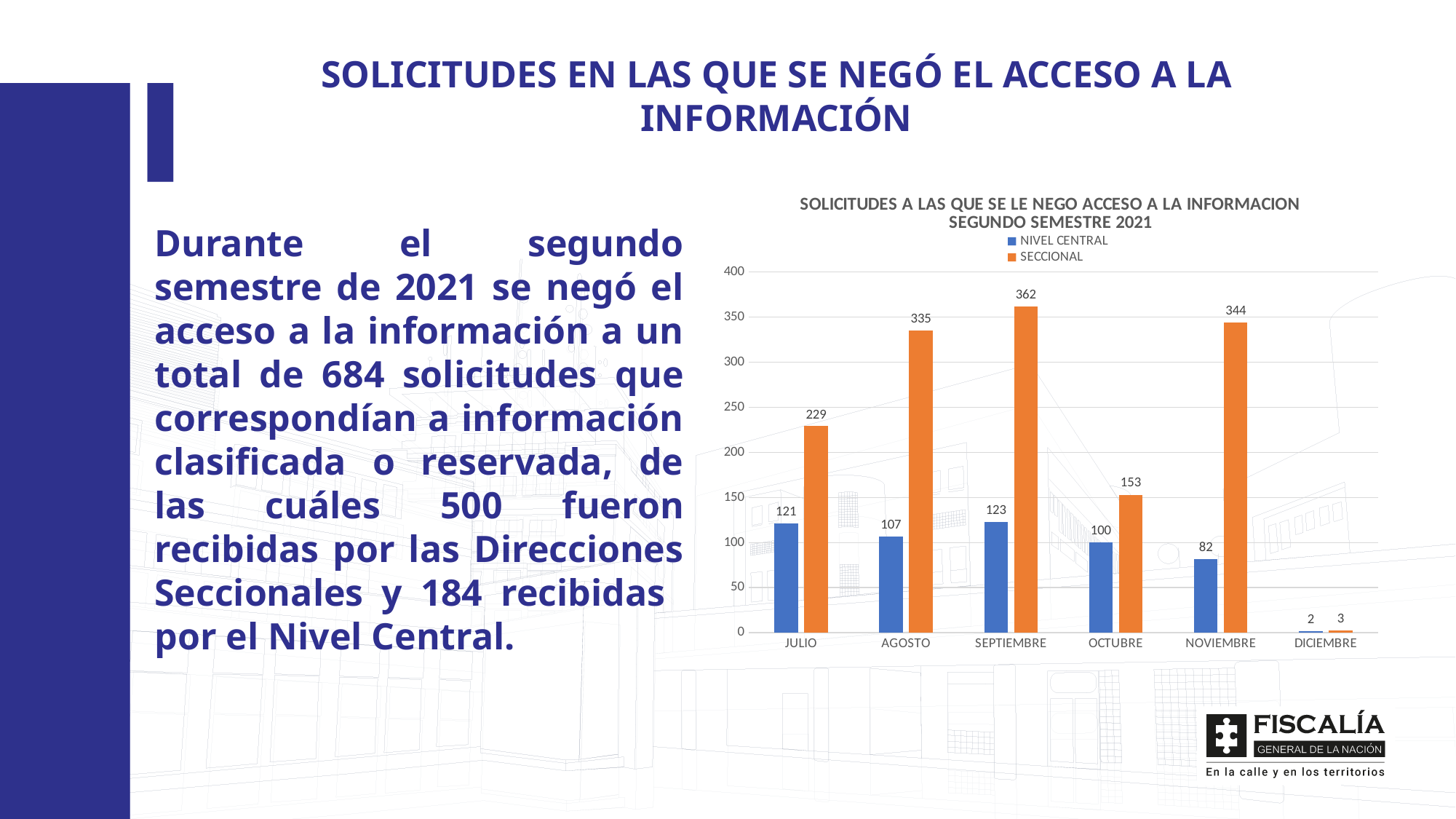
What kind of chart is shown on the slide? Bar chart What is the value for SECCIONAL in OCTUBRE? 153 Which is larger in OCTUBRE, NIVEL CENTRAL or SECCIONAL? SECCIONAL How many months are shown on the x axis? 6 Which month has the highest SECCIONAL value? SEPTIEMBRE What is the value for NIVEL CENTRAL in JULIO? 121 Which colour represents the SECCIONAL series? Orange How many series does the legend list? 2 What is the difference between the SECCIONAL and NIVEL CENTRAL values in AGOSTO? 228 What is the value for SECCIONAL in SEPTIEMBRE? 362 Which month has the lowest NIVEL CENTRAL value? DICIEMBRE What is the value for NIVEL CENTRAL in NOVIEMBRE? 82